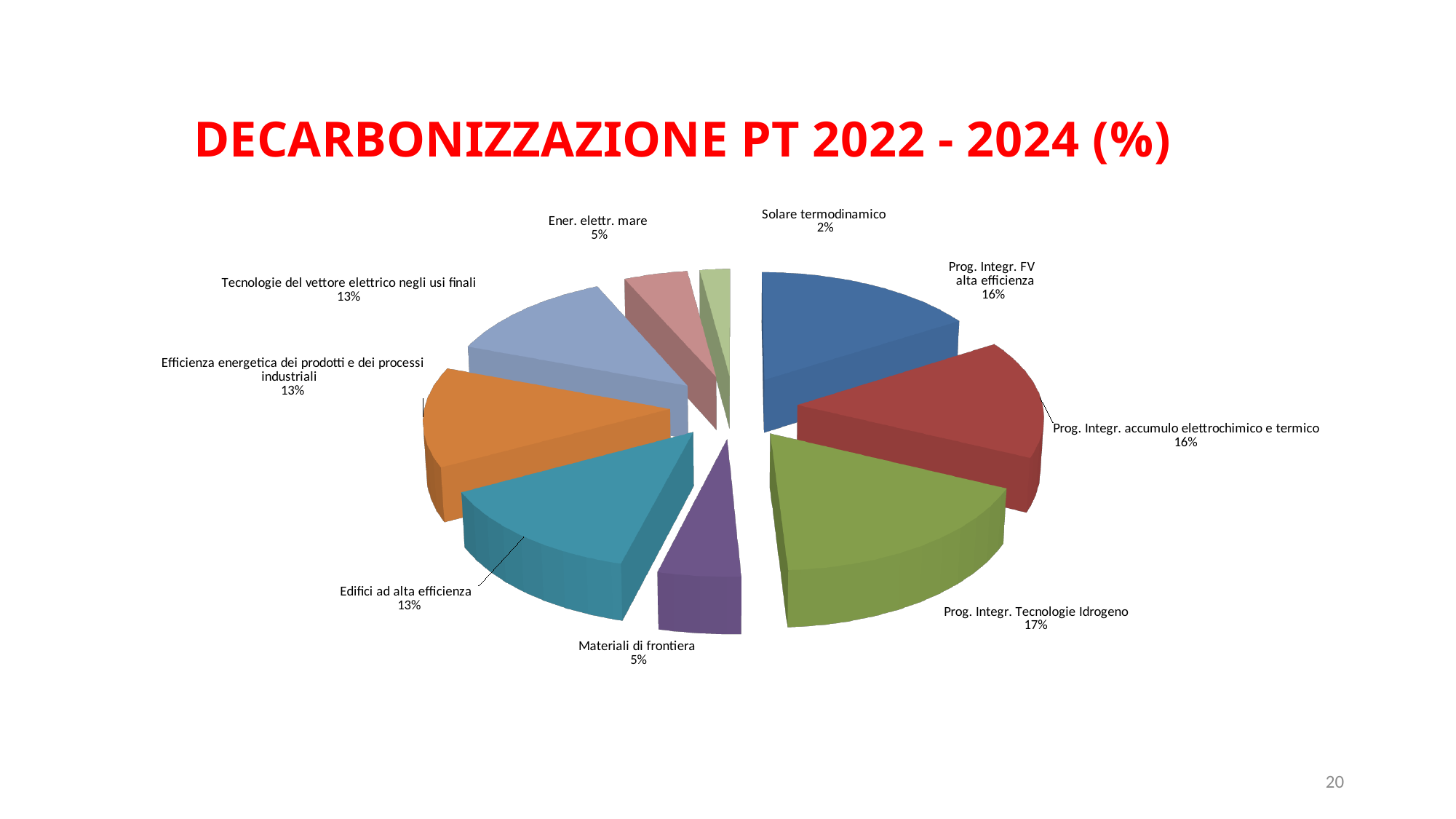
What colour is the slice for Prog. Integr. Tecnologie Idrogeno? Green What share does Ener. elettr. mare have? 5% What share does Prog. Integr. Tecnologie Idrogeno have? 17% What kind of chart is shown on the slide? Pie chart Which category has the smallest share? Solare termodinamico What is the difference between the shares of Prog. Integr. FV alta efficienza and Materiali di frontiera? 11% What share does Solare termodinamico have? 2% What share does Edifici ad alta efficienza have? 13% Which category has the largest share? Prog. Integr. Tecnologie Idrogeno How many slices does the pie chart have? 9 What is the title of the chart? DECARBONIZZAZIONE PT 2022 - 2024 (%) Which is larger, the share of Prog. Integr. accumulo elettrochimico e termico or the share of Tecnologie del vettore elettrico negli usi finali? Prog. Integr. accumulo elettrochimico e termico